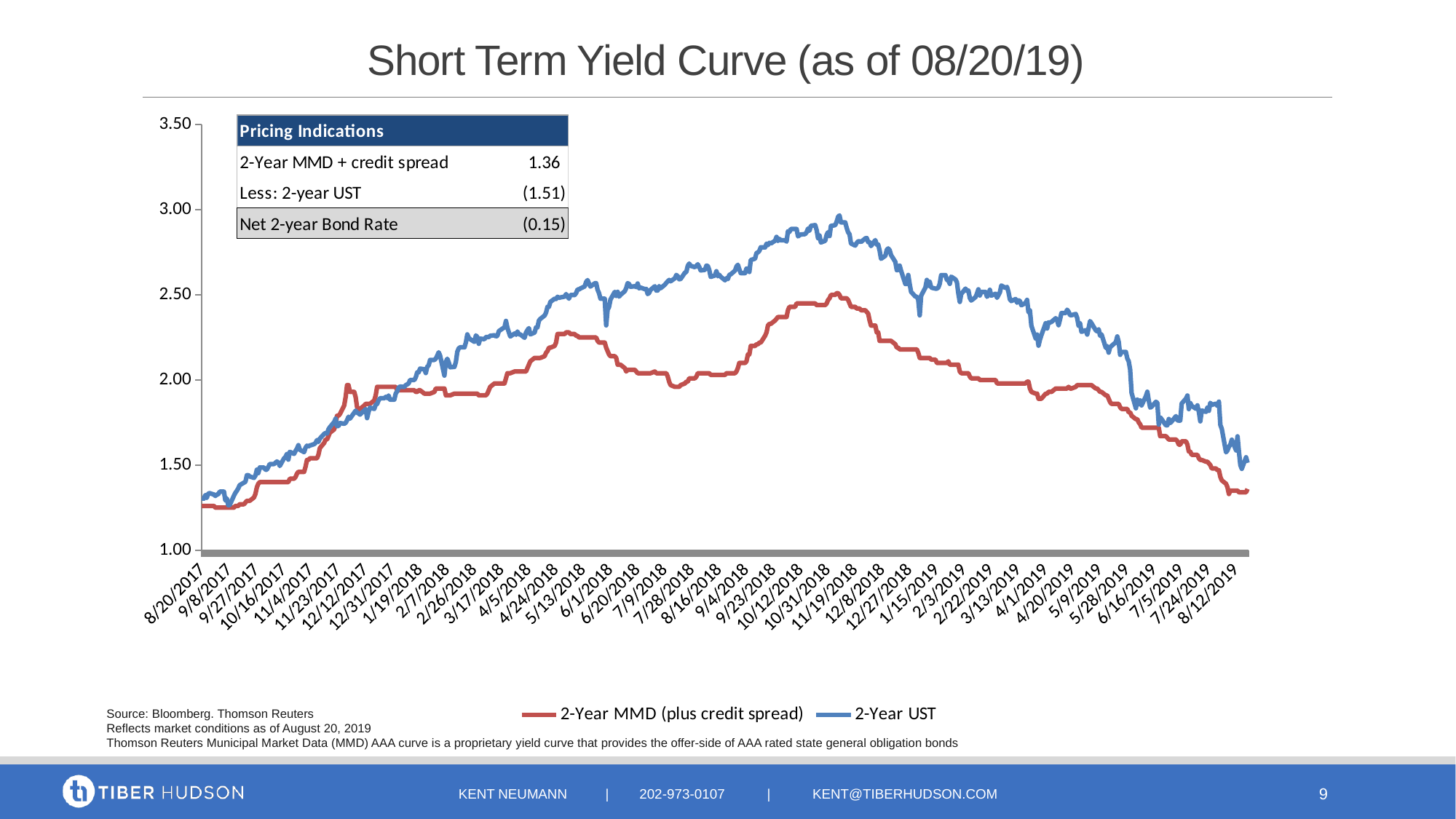
What is the title of the chart? Short Term Yield Curve (as of 08/20/19) How many series does the chart's legend list? 2 According to the Pricing Indications table, what is the value for Less: 2-year UST? (1.51) Which colour is used for the 2-Year UST line? blue Is the 2-Year MMD (plus credit spread) value at 8/20/2017 greater or less than 1.50? less Is the 2-Year UST value around 10/31/2018 greater or less than 2.50? greater Does the 2-Year UST line rise or fall between 10/31/2018 and 8/12/2019? fall Around 10/31/2018, which series is higher: 2-Year UST or 2-Year MMD (plus credit spread)? 2-Year UST What kind of chart is shown on the slide? line chart According to the Pricing Indications table, what is the Net 2-year Bond Rate? (0.15) Is the 2-Year MMD (plus credit spread) value around 5/13/2018 greater or less than 2.00? greater According to the Pricing Indications table, what is the value for 2-Year MMD + credit spread? 1.36